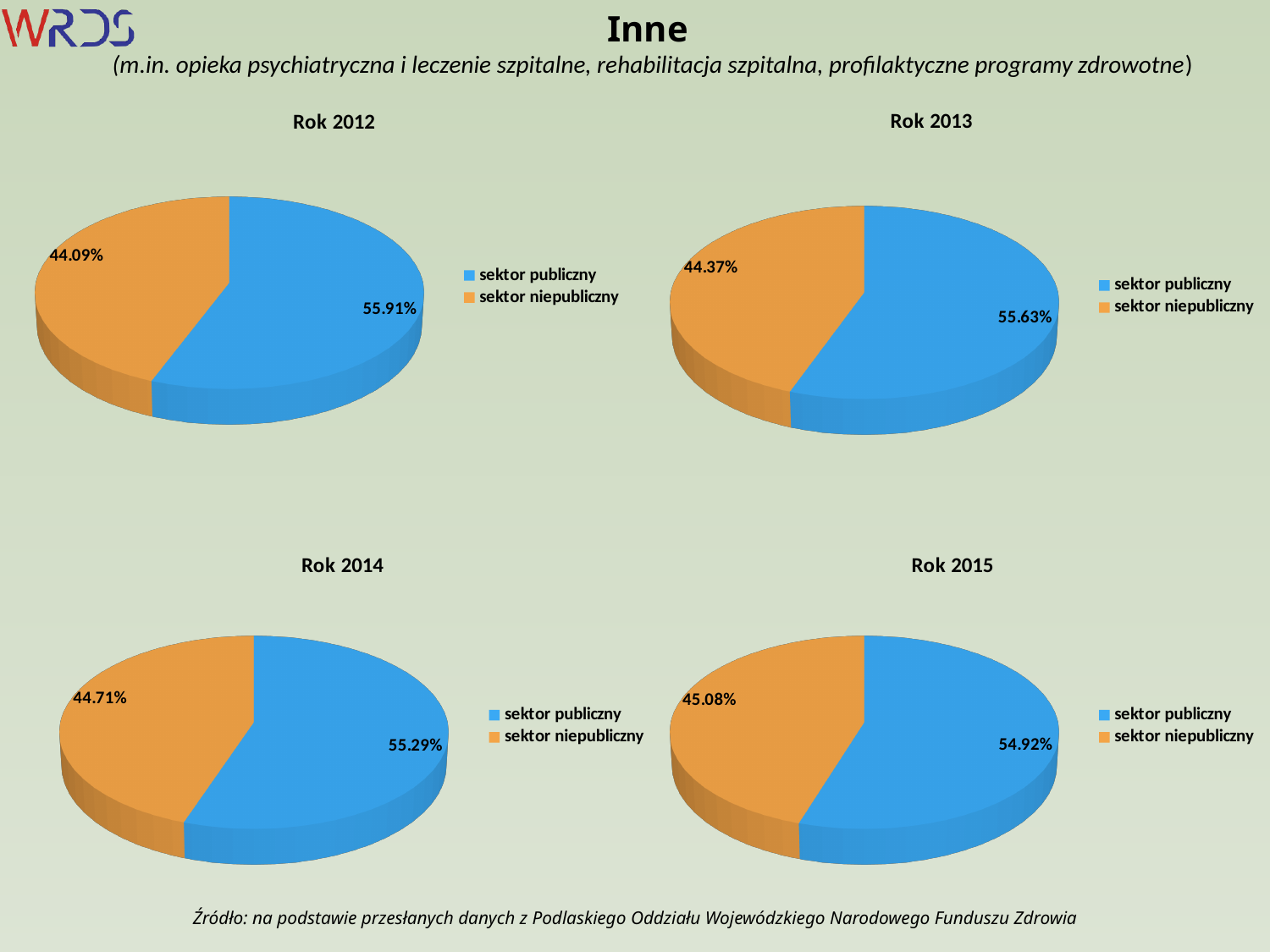
What kind of chart is the 'Rok 2012' chart? pie chart In the 'Rok 2013' chart, what is the difference between the sektor publiczny and sektor niepubliczny shares? 11.26% In the 'Rok 2014' chart, which colour represents sektor niepubliczny? orange In the 'Rok 2012' chart, which sector has the smaller slice? sektor niepubliczny In the 'Rok 2012' chart, what is the share for sektor publiczny? 55.91% In the 'Rok 2014' chart, what is the share for sektor publiczny? 55.29% In the 'Rok 2015' chart, which sector has the larger slice? sektor publiczny How many entries does the legend of the 'Rok 2015' chart list? 2 How many slices does the 'Rok 2013' pie chart have? 2 In the 'Rok 2014' chart, is the share for sektor publiczny larger or smaller than the share for sektor niepubliczny? larger In the 'Rok 2015' chart, what is the share for sektor niepubliczny? 45.08% In the 'Rok 2013' chart, what is the share for sektor niepubliczny? 44.37%